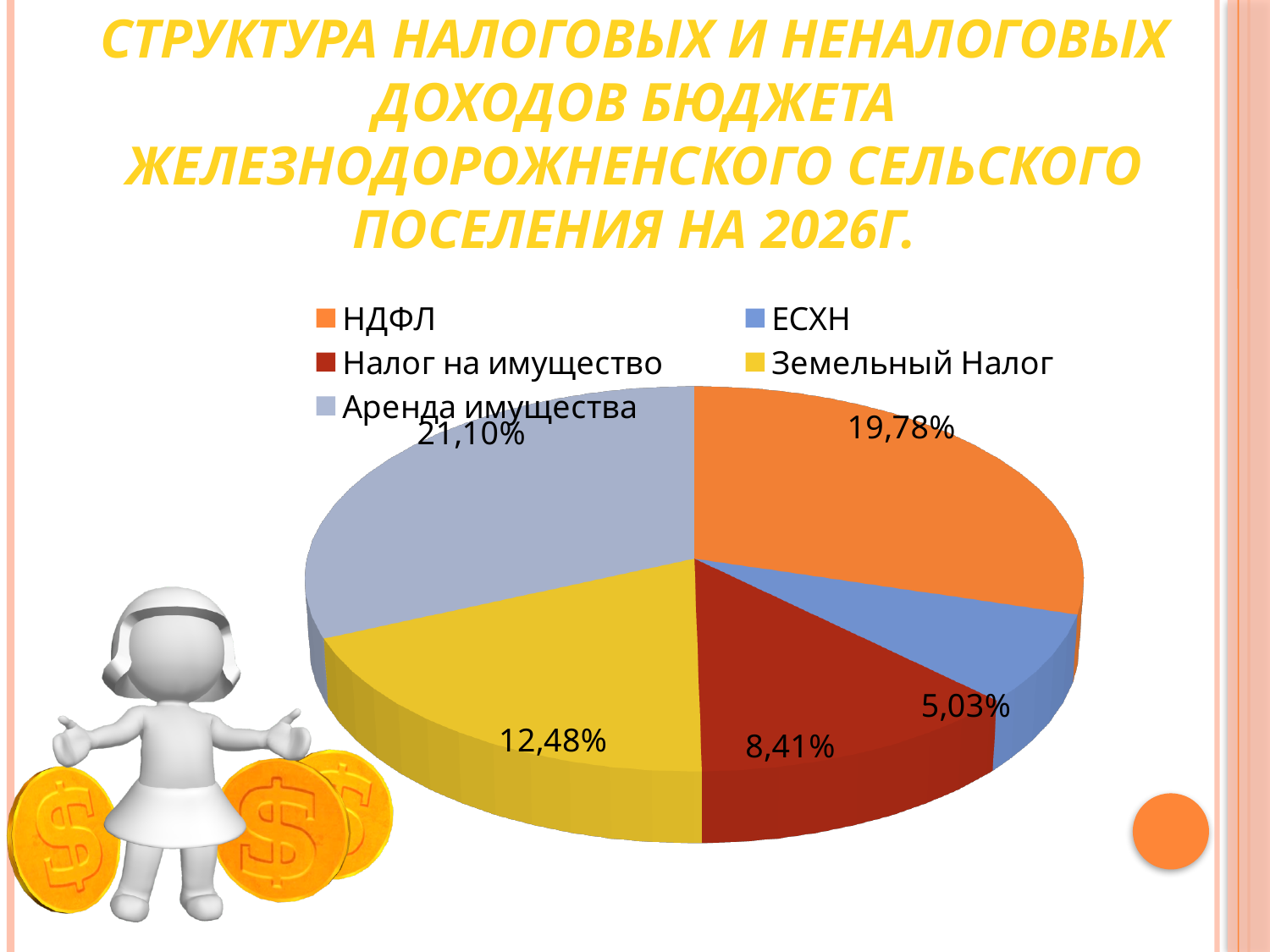
What type of chart is shown on the slide? pie chart What is the value shown for НДФЛ? 19,78% How many slices does the pie chart have? 5 Which category has the largest value in the pie chart? Аренда имущества Which category has the smallest value in the pie chart? ЕСХН What is the value shown for ЕСХН? 5,03% Which colour represents НДФЛ in the pie chart? orange How many entries does the legend list? 5 What is the value shown for Налог на имущество? 8,41% What is the difference between the values for Земельный Налог and Налог на имущество? 4,07% What share of the pie is labelled for Аренда имущества? 21,10% What is the value shown for Земельный Налог? 12,48%